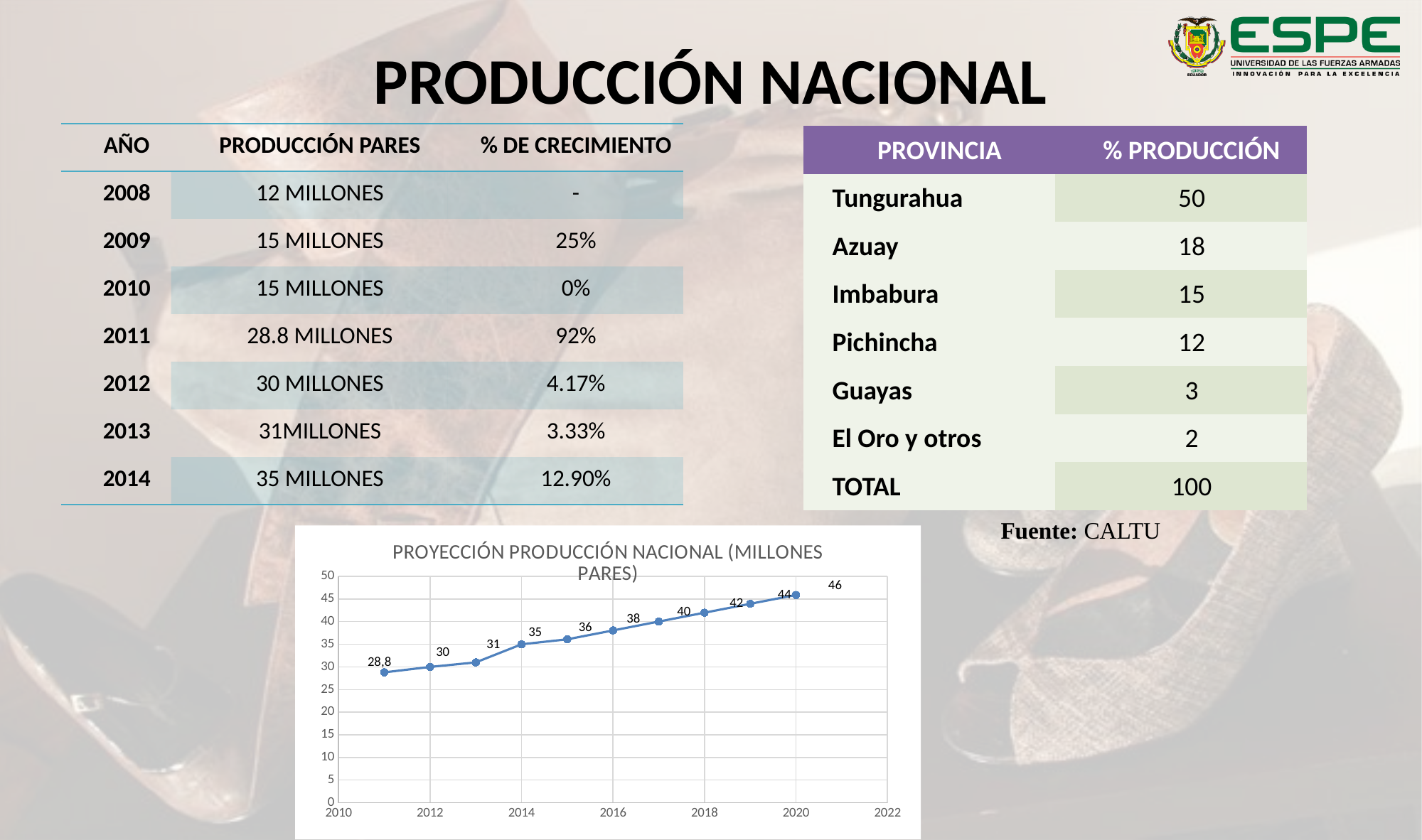
What is the projected production value for 2020 in the chart? 46 Which year has the highest value in the chart? 2020 Which is larger in the chart, the value for 2016 or the value for 2018? 2018 By how much does the value for 2014 exceed the value for 2012 in the chart? 5 What is the projected production value for 2014 in the chart? 35 What kind of chart is shown on the slide? line chart Which year has the lowest value in the chart? 2011 How many data points are plotted in the chart? 10 What is the value plotted for 2011 in the chart? 28,8 What is the title of the chart? PROYECCIÓN PRODUCCIÓN NACIONAL (MILLONES PARES) Do the values in the chart rise or fall from 2011 to 2020? rise What is the value plotted for 2017 in the chart? 40